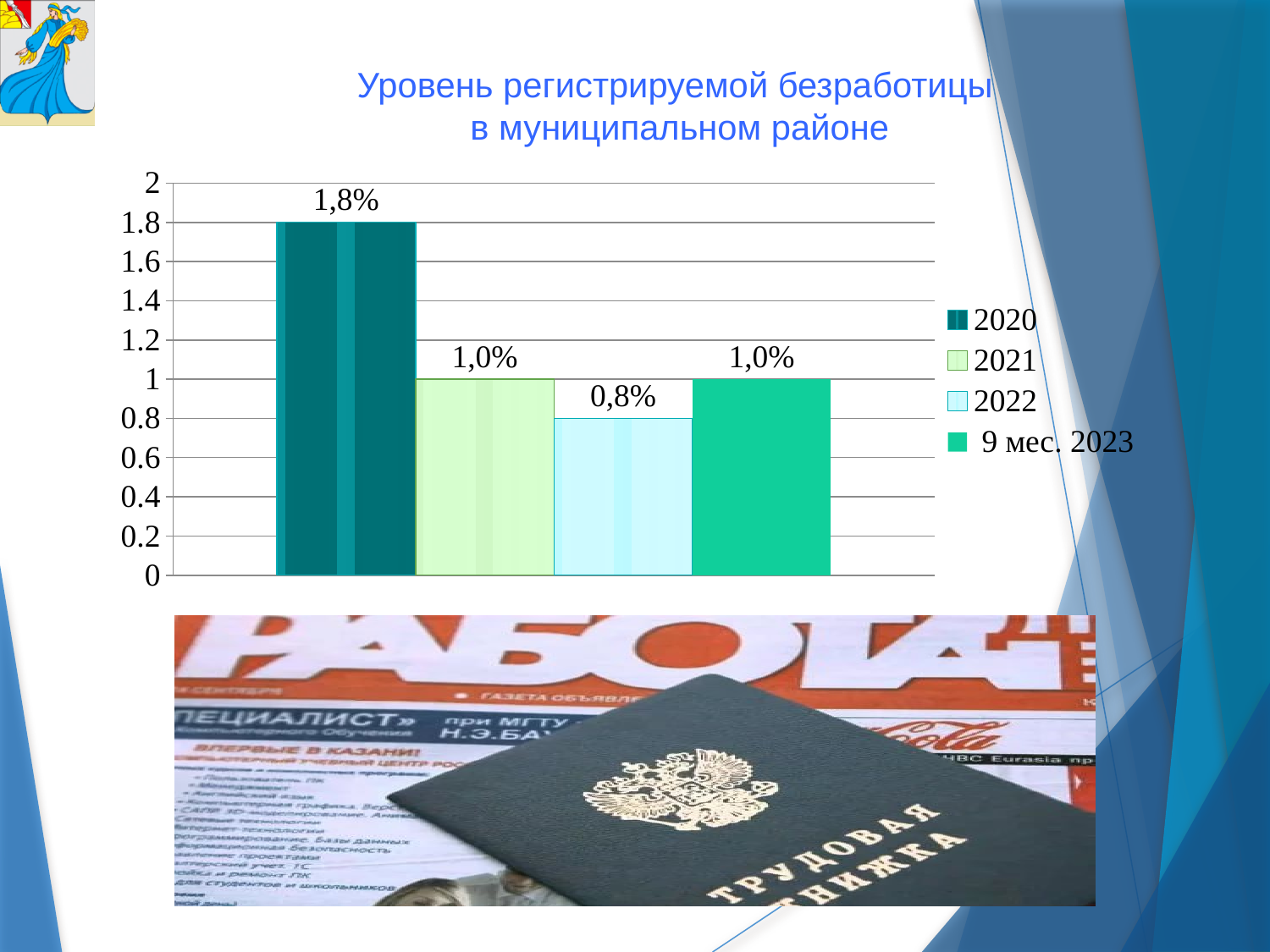
What kind of chart is shown on the slide? Bar chart What is the registered unemployment rate shown for 2022? 0,8% Which is larger, the value for 2020 or the value for 2022? 2020 What is the registered unemployment rate shown for 2020? 1,8% Is the value for 2020 greater or less than 1.6? greater What value is shown for 9 мес. 2023? 1,0% How many bars are plotted in the chart? 4 Which period has the lowest registered unemployment rate? 2022 How many entries does the legend list? 4 What is the difference between the 2021 value and the 2022 value? 0,2% Which period has the highest registered unemployment rate? 2020 What is the difference between the 2020 value and the 2021 value? 0,8%